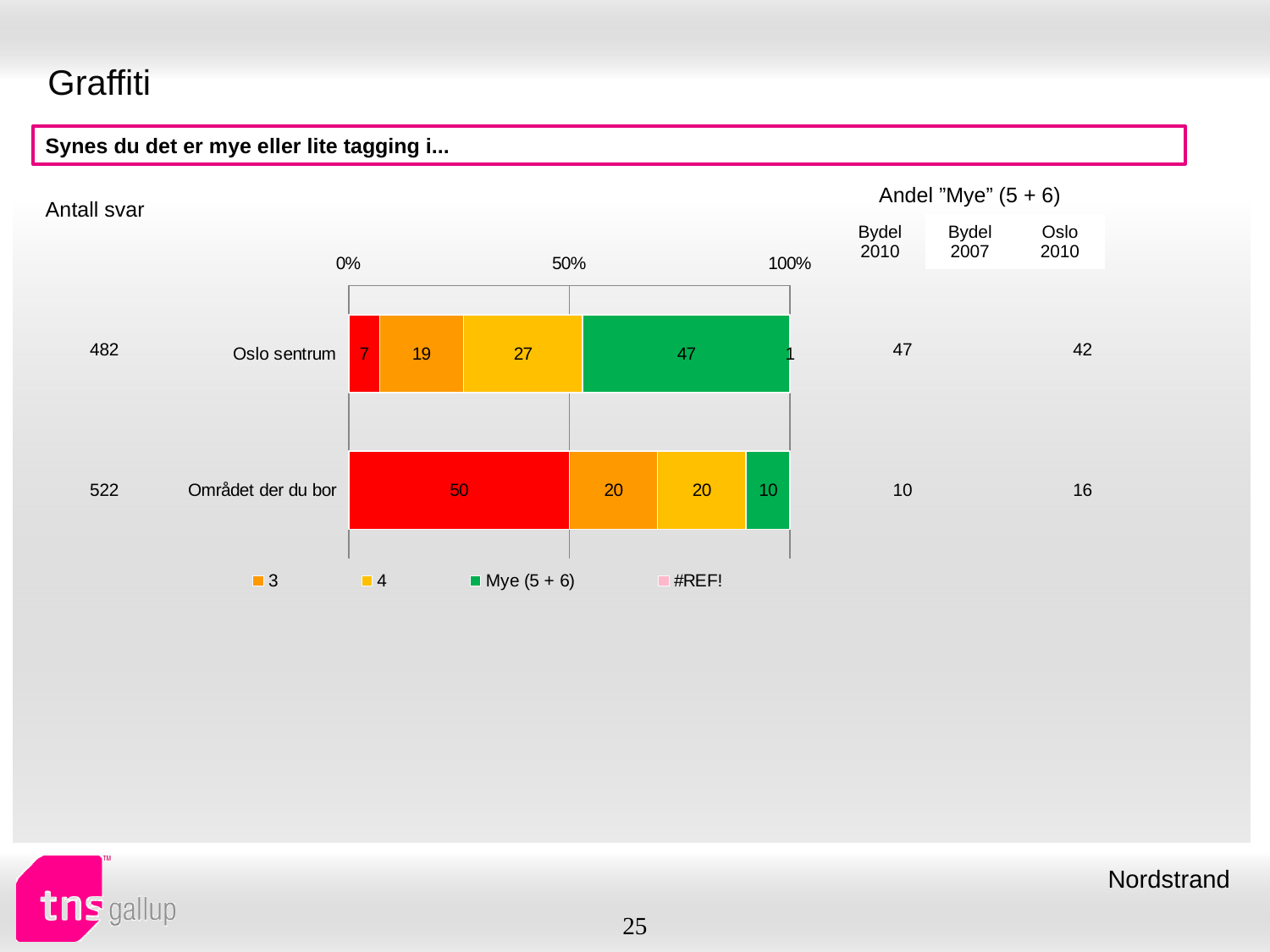
What kind of chart is shown on the slide? Stacked bar chart What is the value of the "3" segment for Området der du bor? 20 Which category has the larger "Mye (5 + 6)" value, Oslo sentrum or Området der du bor? Oslo sentrum What is the value of the "4" segment for Oslo sentrum? 27 What is the number of responses (Antall svar) for Området der du bor? 522 What is the difference between the "4" and "3" segments for Oslo sentrum? 8 How many categories are shown on the chart? 2 How many entries does the chart legend list? 4 What is the difference between the "Mye (5 + 6)" values for Oslo sentrum and Området der du bor? 37 What is the value of the "3" segment for Oslo sentrum? 19 What is the value of the "Mye (5 + 6)" segment for Oslo sentrum? 47 What is the value of the "Mye (5 + 6)" segment for Området der du bor? 10